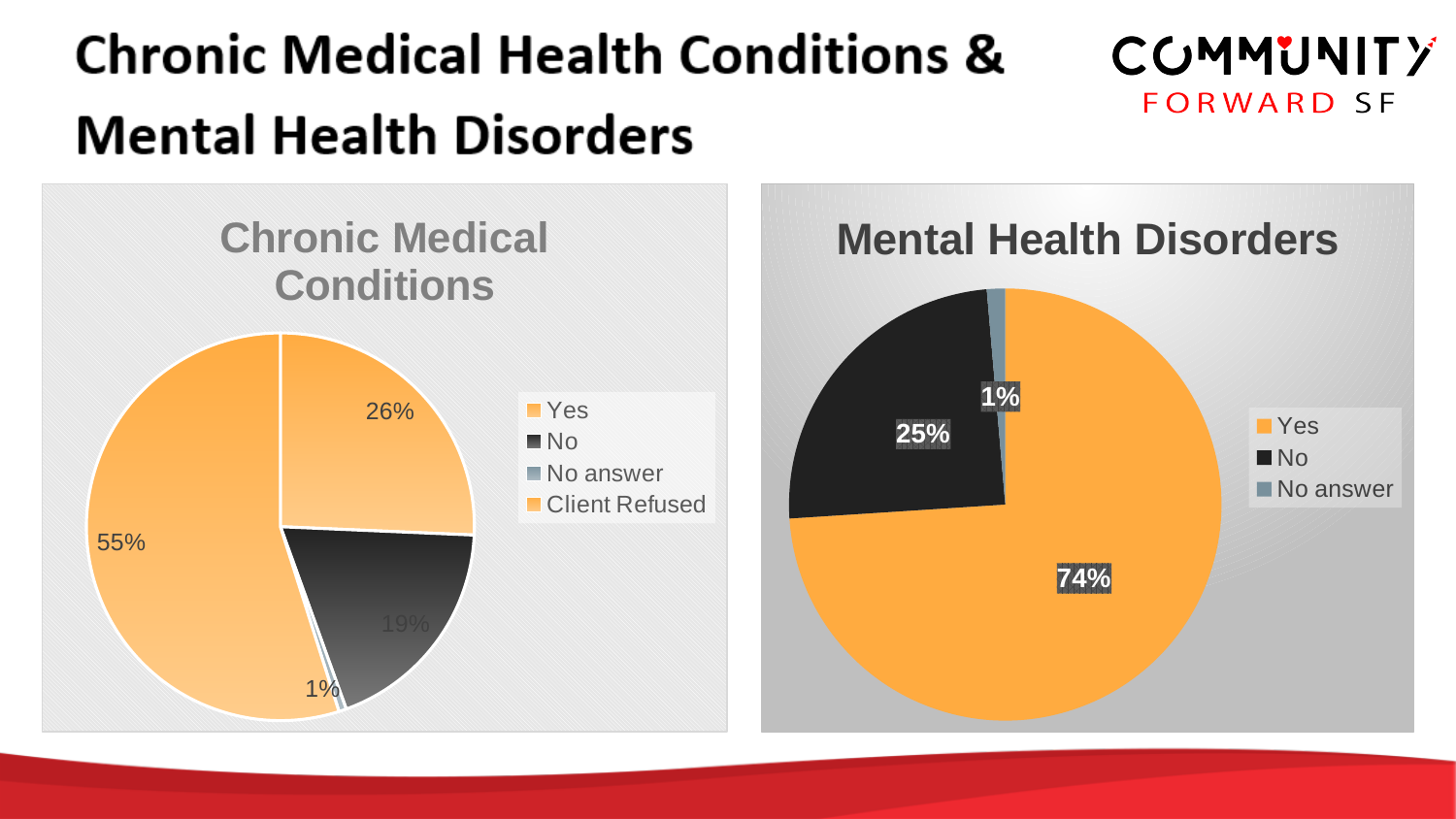
In the Mental Health Disorders chart, how many categories does the legend list? 3 What type of chart is the Chronic Medical Conditions chart? Pie chart In the Mental Health Disorders chart, what is the difference in percentage points between Yes and No? 49 In the Chronic Medical Conditions chart, what percentage is shown for No answer? 1% In the Mental Health Disorders chart, what percentage is shown for No? 25% In the Chronic Medical Conditions chart, what percentage is shown for No? 19% In the Mental Health Disorders chart, what percentage is shown for Yes? 74% In the Mental Health Disorders chart, what percentage is shown for No answer? 1% In the Mental Health Disorders chart, which category has the largest share? Yes In the Chronic Medical Conditions chart, what is the percentage of the largest slice? 55% In the Chronic Medical Conditions chart, how many categories does the legend list? 4 In the Mental Health Disorders chart, which category has the smallest share? No answer